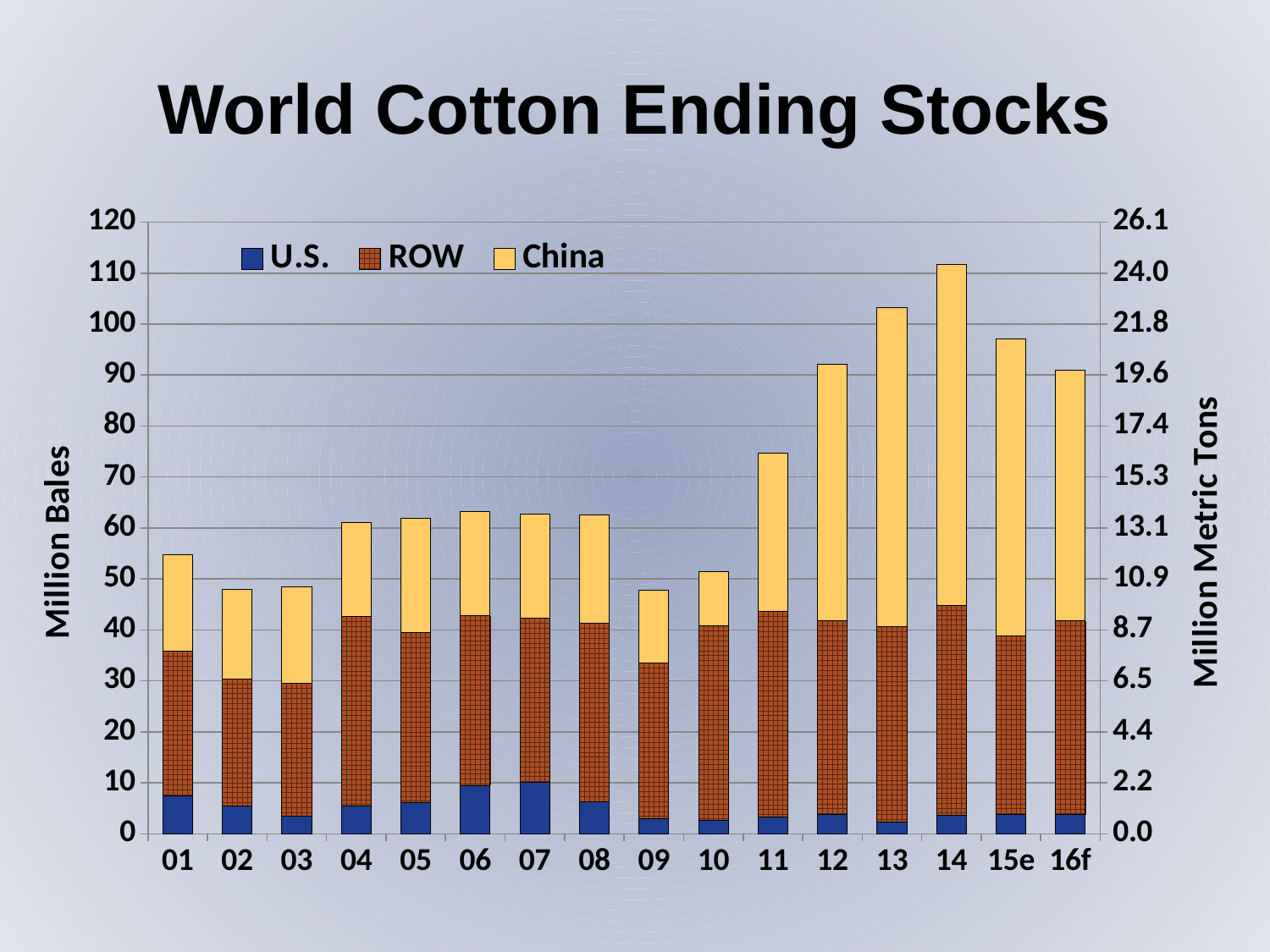
Do total ending stocks rise or fall from 10 to 14? rise How many series does the legend list? 3 Is the total for 14 greater or less than 100 million bales? greater What is the title of the left vertical axis? Million Bales Which has the larger total ending stocks, 13 or 14? 14 Which year has the highest total ending stocks? 14 Is the total for 11 greater or less than 70 million bales? greater What is the title of the chart? World Cotton Ending Stocks How many years (categories) are shown along the x axis? 16 What kind of chart is shown on the slide? Stacked bar chart Is the total for 01 greater or less than 60 million bales? less